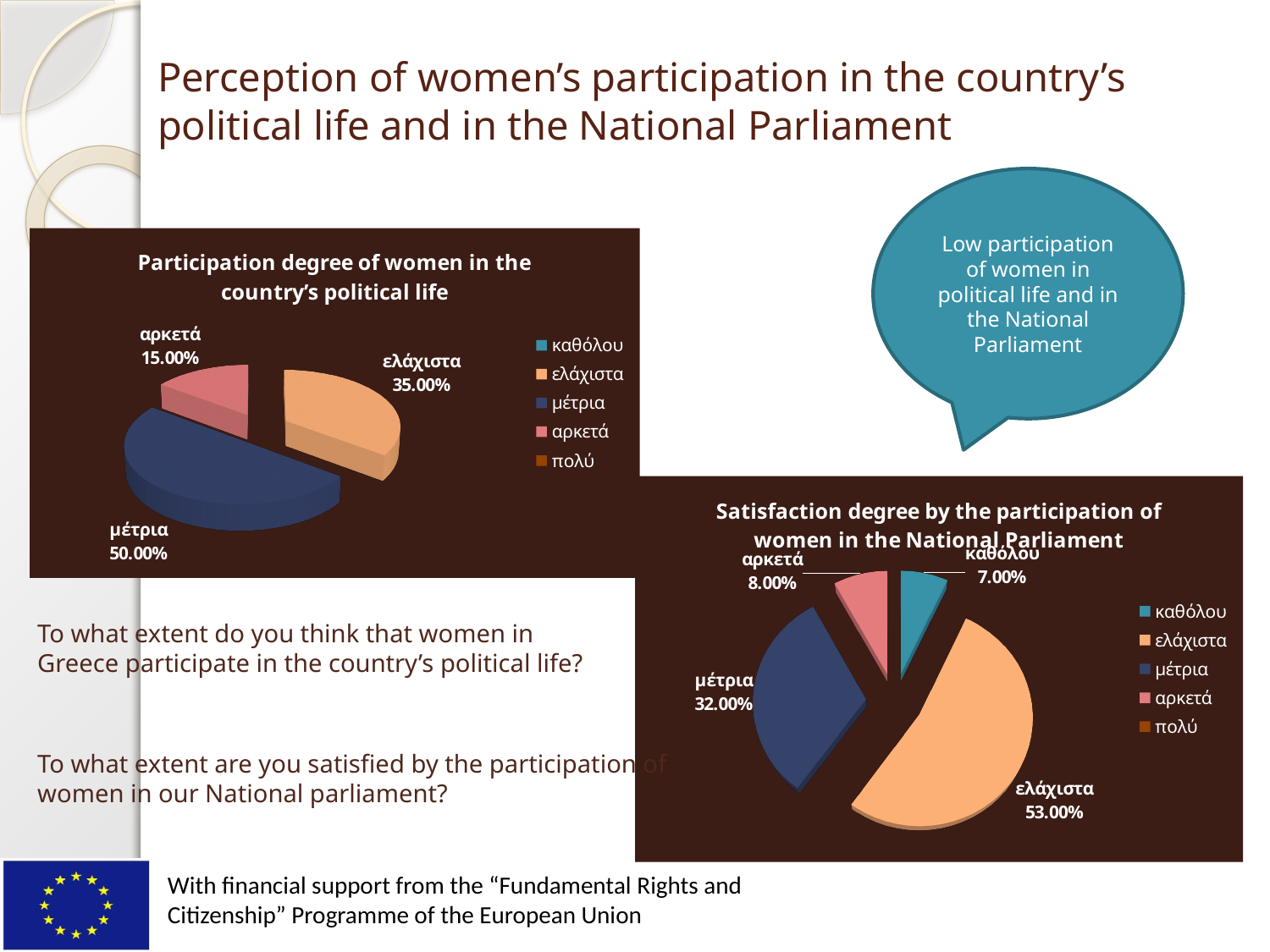
How many entries does the legend of the chart titled "Satisfaction degree by the participation of women in the National Parliament" list? 5 In the chart titled "Participation degree of women in the country's political life", which labelled slice is the smallest? αρκετά In the chart titled "Participation degree of women in the country's political life", what is the value for μέτρια? 50.00% In the chart titled "Participation degree of women in the country's political life", what is the value for ελάχιστα? 35.00% In the chart titled "Satisfaction degree by the participation of women in the National Parliament", what is the value for καθόλου? 7.00% In the chart titled "Participation degree of women in the country's political life", which labelled slice is the largest? μέτρια In the chart titled "Participation degree of women in the country's political life", what is the difference between the μέτρια and ελάχιστα values? 15.00% In the chart titled "Satisfaction degree by the participation of women in the National Parliament", what is the value for ελάχιστα? 53.00% In the chart titled "Satisfaction degree by the participation of women in the National Parliament", which is larger, μέτρια or αρκετά? μέτρια What type of chart is the chart titled "Participation degree of women in the country's political life"? Pie chart In the chart titled "Satisfaction degree by the participation of women in the National Parliament", how many slices have data labels? 4 In the chart titled "Satisfaction degree by the participation of women in the National Parliament", what is the difference between the ελάχιστα and μέτρια values? 21.00%